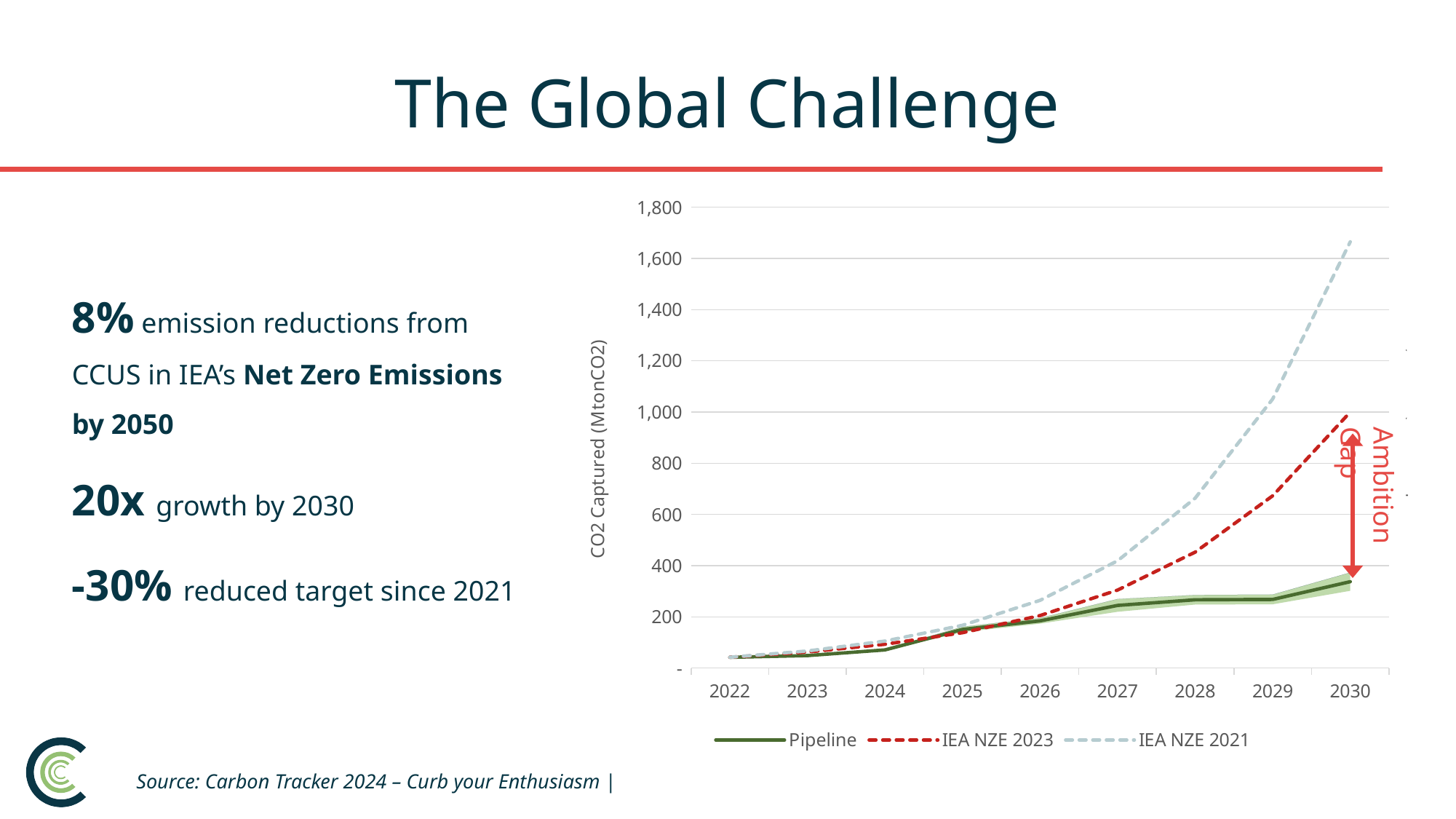
What label is written next to the red arrow at the right of the chart? Ambition Gap Which series has the highest value in 2030? IEA NZE 2021 Does the IEA NZE 2021 series rise or fall from 2022 to 2030? Rise Is the value for Pipeline in 2030 greater or less than 400? less In 2030, which is larger: IEA NZE 2023 or Pipeline? IEA NZE 2023 What is the label on the y axis of the chart? CO2 Captured (MtonCO2) Is the value for IEA NZE 2021 in 2030 greater or less than 1,400? greater Is the value for IEA NZE 2023 in 2030 greater or less than 800? greater Which series has the lowest value in 2030? Pipeline How many series does the chart legend list? 3 How many years are shown along the x axis of the chart? 9 What kind of chart is shown on the slide? Line chart